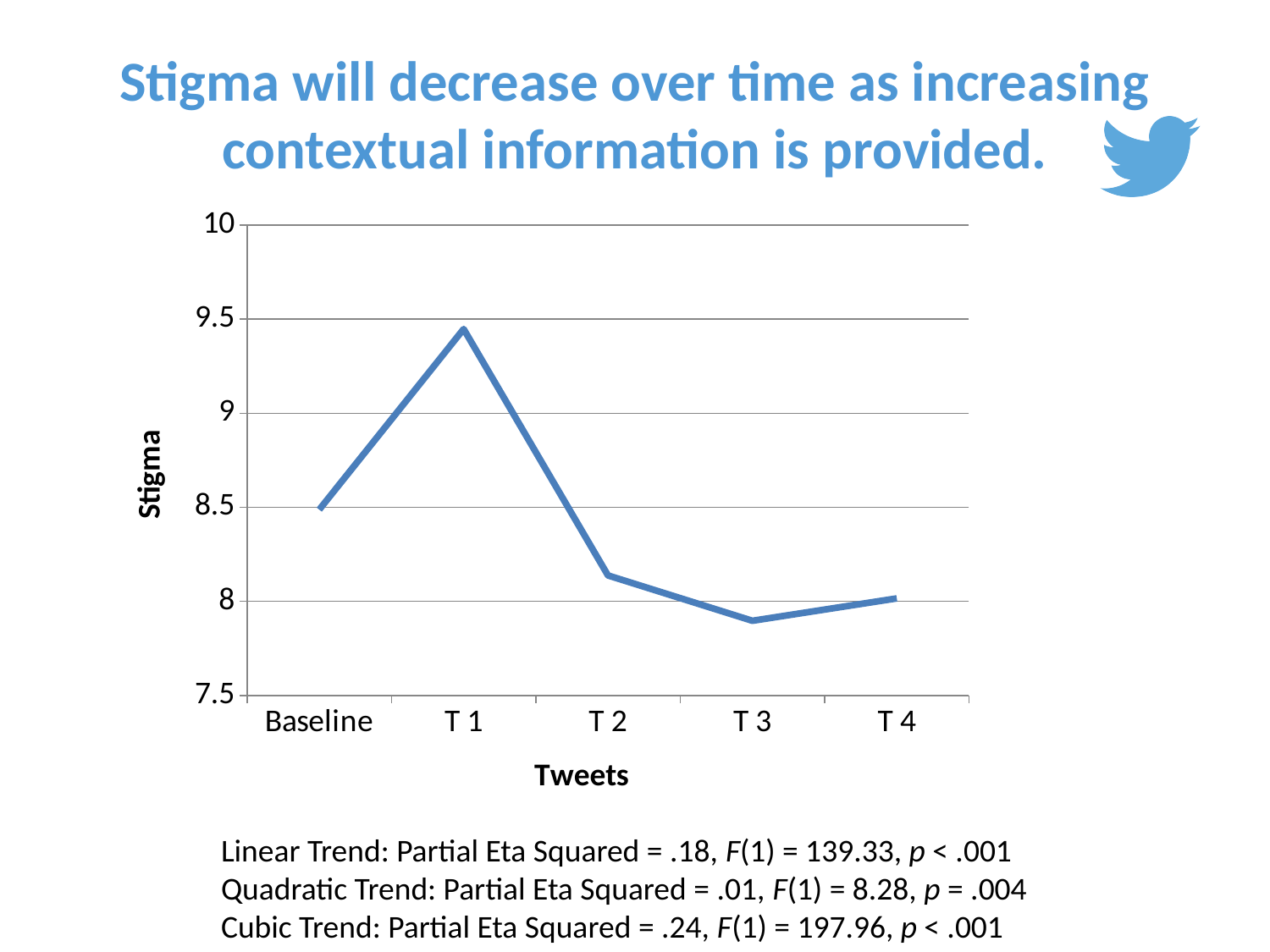
At which point on the x axis is Stigma lowest? T 3 Does the Stigma value rise or fall from T 1 to T 3? fall Is the value for T 3 greater or less than 8? less What is the title of the chart's x axis? Tweets Which has the higher Stigma value, T 1 or T 2? T 1 Is the value for T 2 greater or less than 8.5? less Is the value for T 1 greater or less than 9? greater At which point on the x axis is Stigma highest? T 1 How many points are plotted along the x axis of the chart? 5 What kind of chart is shown on the slide? line chart Which has the higher Stigma value, Baseline or T 3? Baseline